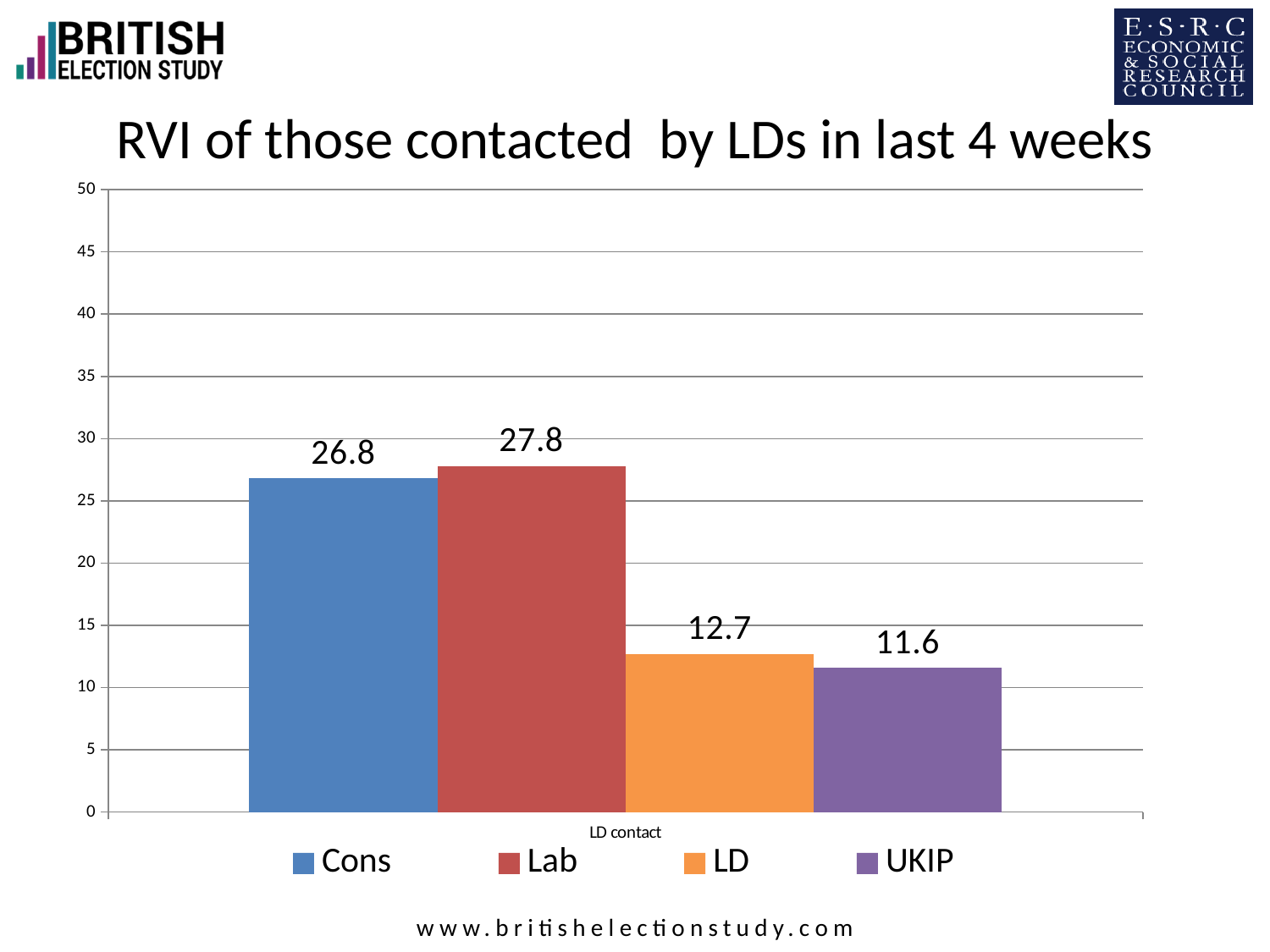
Which series has the lowest value? UKIP What kind of chart is shown on the slide? bar chart What is the difference between the values for Lab and Cons? 1.0 Is the value for Cons greater or less than 25? greater What is the difference between the values for Cons and LD? 14.1 Which is larger, the value for LD or the value for UKIP? LD How many series does the legend list? 4 What is the value for Cons? 26.8 What is the value for UKIP? 11.6 Which series has the highest value? Lab What is the value for Lab? 27.8 What is the value for LD? 12.7